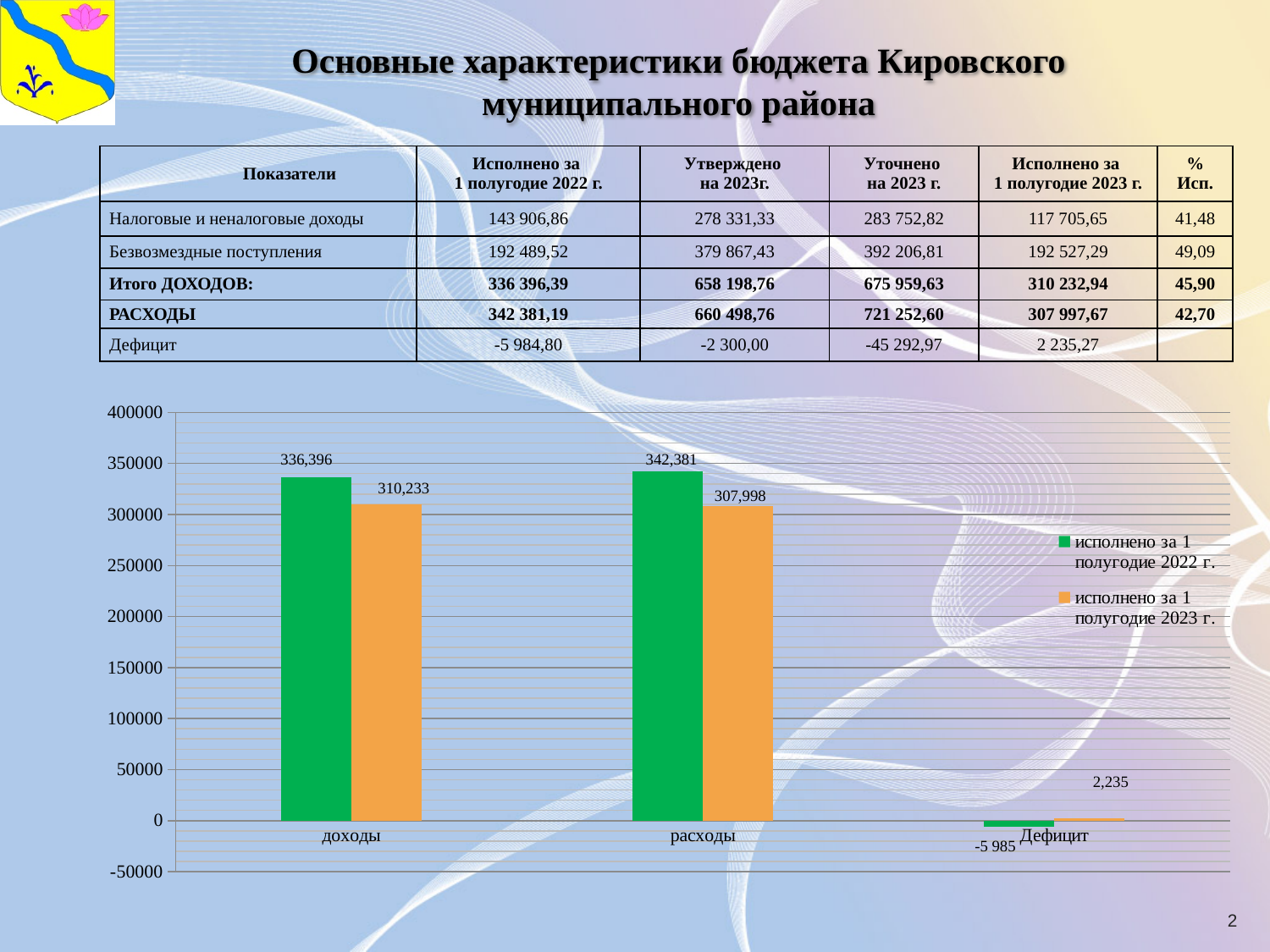
What is the value for доходы in the series исполнено за 1 полугодие 2023 г.? 310,233 Which category has the lowest value in the series исполнено за 1 полугодие 2022 г.? Дефицит What is the difference between the доходы values for исполнено за 1 полугодие 2022 г. and исполнено за 1 полугодие 2023 г.? 26,163 What type of chart is shown on the slide? bar chart How many categories are shown on the x axis of the chart? 3 What is the value for расходы in the series исполнено за 1 полугодие 2022 г.? 342,381 What is the value for Дефицит in the series исполнено за 1 полугодие 2023 г.? 2,235 Which colour represents the series исполнено за 1 полугодие 2023 г. in the chart? orange Which is larger for расходы: the value for исполнено за 1 полугодие 2022 г. or for исполнено за 1 полугодие 2023 г.? исполнено за 1 полугодие 2022 г. How many series does the chart legend list? 2 What is the value for доходы in the series исполнено за 1 полугодие 2022 г.? 336,396 Which category has the highest value in the series исполнено за 1 полугодие 2023 г.? доходы